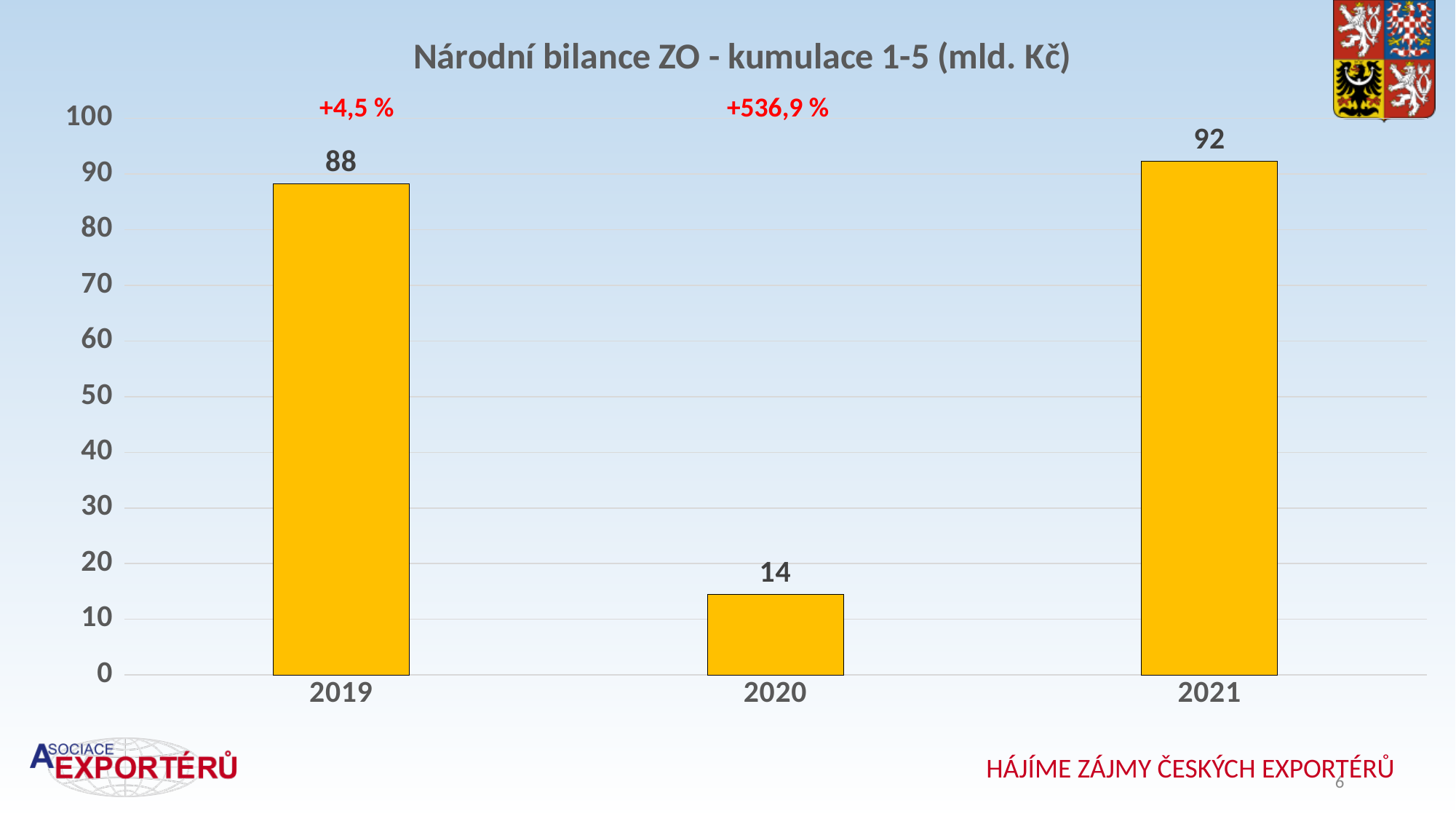
What is the difference between the values for 2021 and 2019? 4 What is the title of the chart? Národní bilance ZO - kumulace 1-5 (mld. Kč) Which is larger, the value for 2020 or the value for 2021? 2021 What is the value for 2019? 88 How many years are shown on the chart? 3 Which year has the highest value? 2021 Which year has the lowest value? 2020 Is the value for 2020 greater or less than 20? less What is the difference between the values for 2019 and 2020? 74 What is the value for 2021? 92 What is the value for 2020? 14 What kind of chart is shown on the slide? bar chart